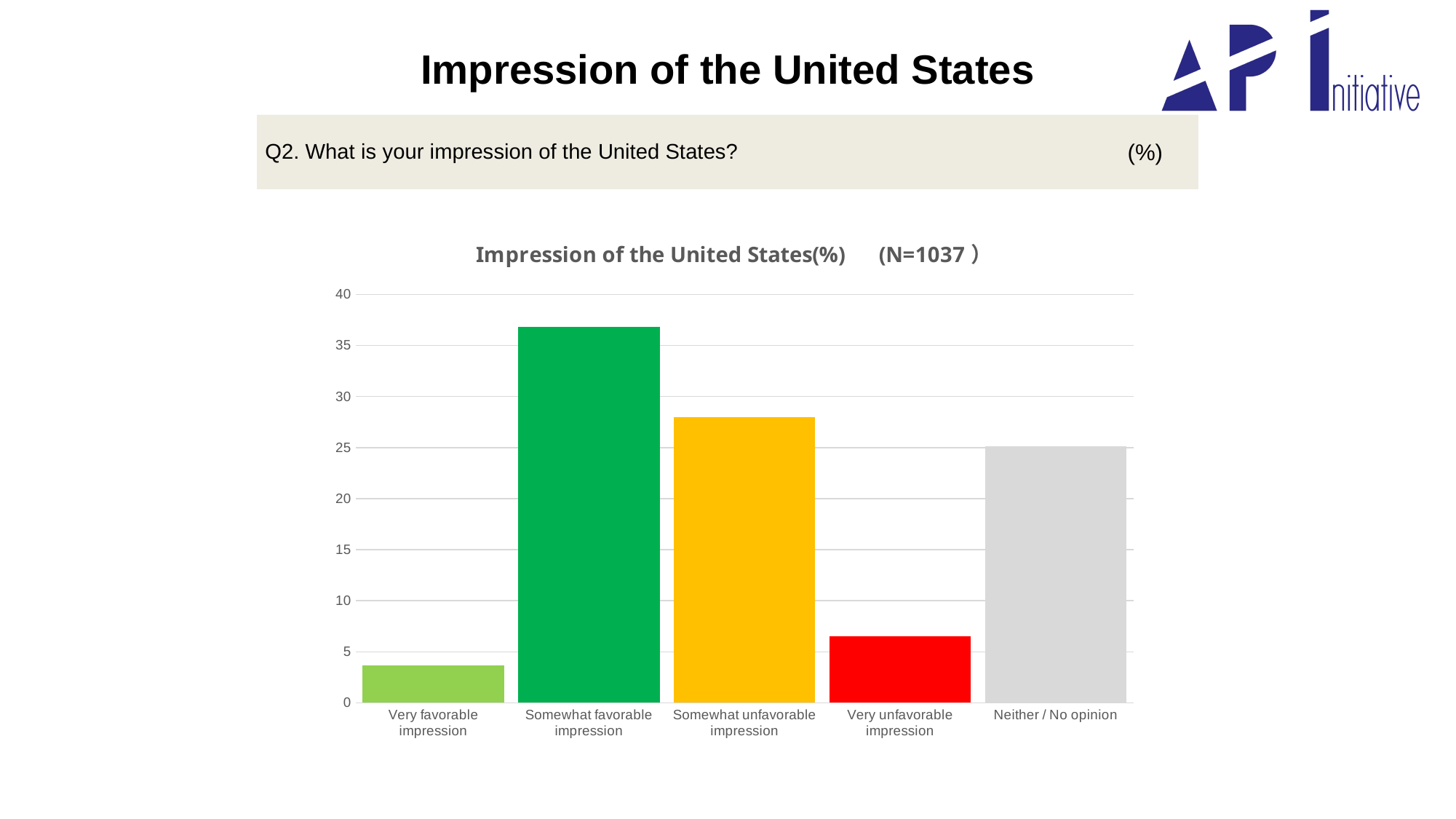
Which is larger: the value for Somewhat unfavorable impression or the value for Neither / No opinion? Somewhat unfavorable impression Is the value for Somewhat favorable impression greater or less than 35? greater What kind of chart is shown on the slide? bar chart What sample size (N) is stated in the chart title? N=1037 Which category has the lowest value in the chart? Very favorable impression Is the value for Very unfavorable impression greater or less than 5? greater Is the value for Neither / No opinion greater or less than 30? less Which is larger: the value for Very unfavorable impression or the value for Very favorable impression? Very unfavorable impression How many categories are shown on the x axis of the chart? 5 Which category has the highest value in the chart? Somewhat favorable impression